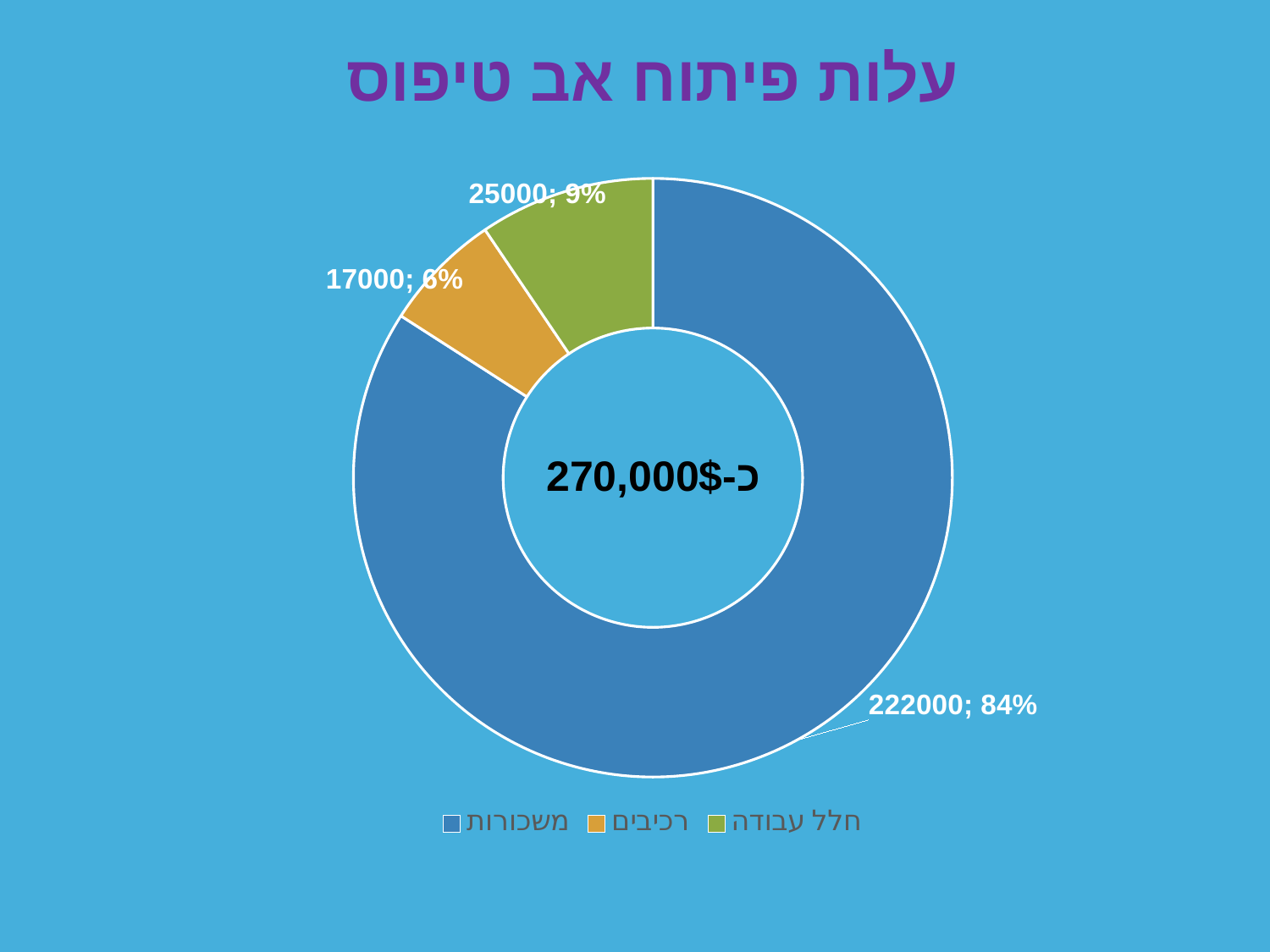
What is the difference between the values for חלל עבודה and רכיבים? 8000 What kind of chart is shown on the slide? Doughnut chart What is the value shown for רכיבים? 17000 What percentage share does חלל עבודה have? 9% What percentage share does משכורות have? 84% Which category has the largest value? משכורות How many categories does the chart show? 3 Which is larger, the value for חלל עבודה or the value for רכיבים? חלל עבודה What is the value shown for חלל עבודה? 25000 Which category has the smallest value? רכיבים What is the value shown for משכורות? 222000 What total is written in the centre of the doughnut? כ-270,000$